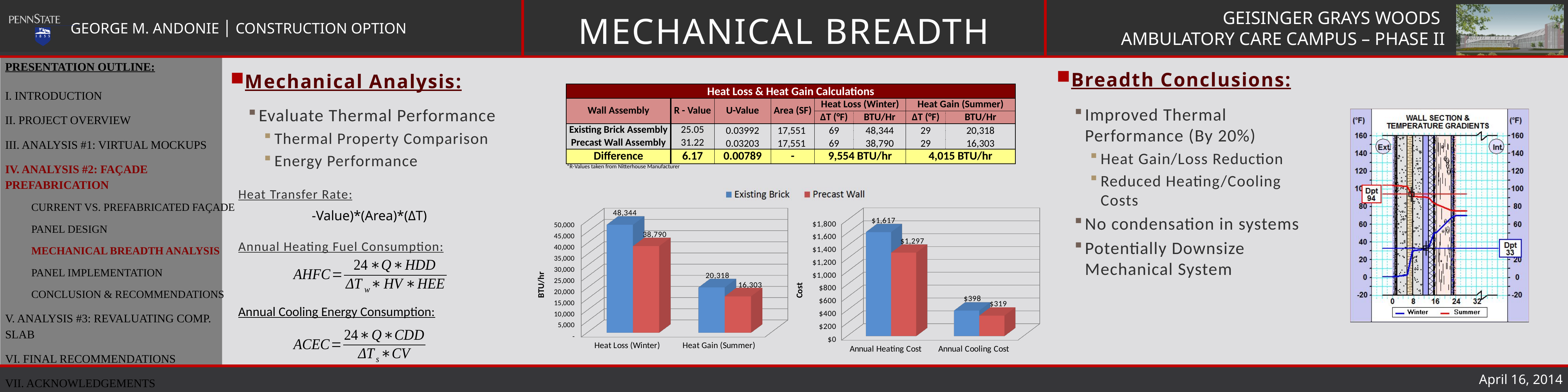
In the right bar chart (Cost), what is the Annual Heating Cost for Precast Wall? $1,297 In the left bar chart (BTU/hr), which series has the higher value for Heat Gain (Summer), Existing Brick or Precast Wall? Existing Brick In the right bar chart (Cost), what is the difference between the Existing Brick and Precast Wall values for Annual Cooling Cost? $79 In the left bar chart (BTU/hr), what is the Heat Loss (Winter) value for Existing Brick? 48,344 In the left bar chart (BTU/hr), what is the difference between the Existing Brick and Precast Wall values for Heat Loss (Winter)? 9,554 In the right bar chart (Cost), what is the Annual Cooling Cost for Existing Brick? $398 How many categories are shown on the x axis of the right bar chart (Cost)? 2 What type of chart is used to show the BTU/hr heat loss and heat gain data? Bar chart In the left bar chart (BTU/hr), what is the Heat Gain (Summer) value for Precast Wall? 16,303 In the left bar chart (BTU/hr), is the Precast Wall value for Heat Loss (Winter) greater or less than 35,000? greater How many series does the shared legend above the two bar charts list? 2 In the right bar chart (Cost), which category has the lowest bar? Annual Cooling Cost (Precast Wall)